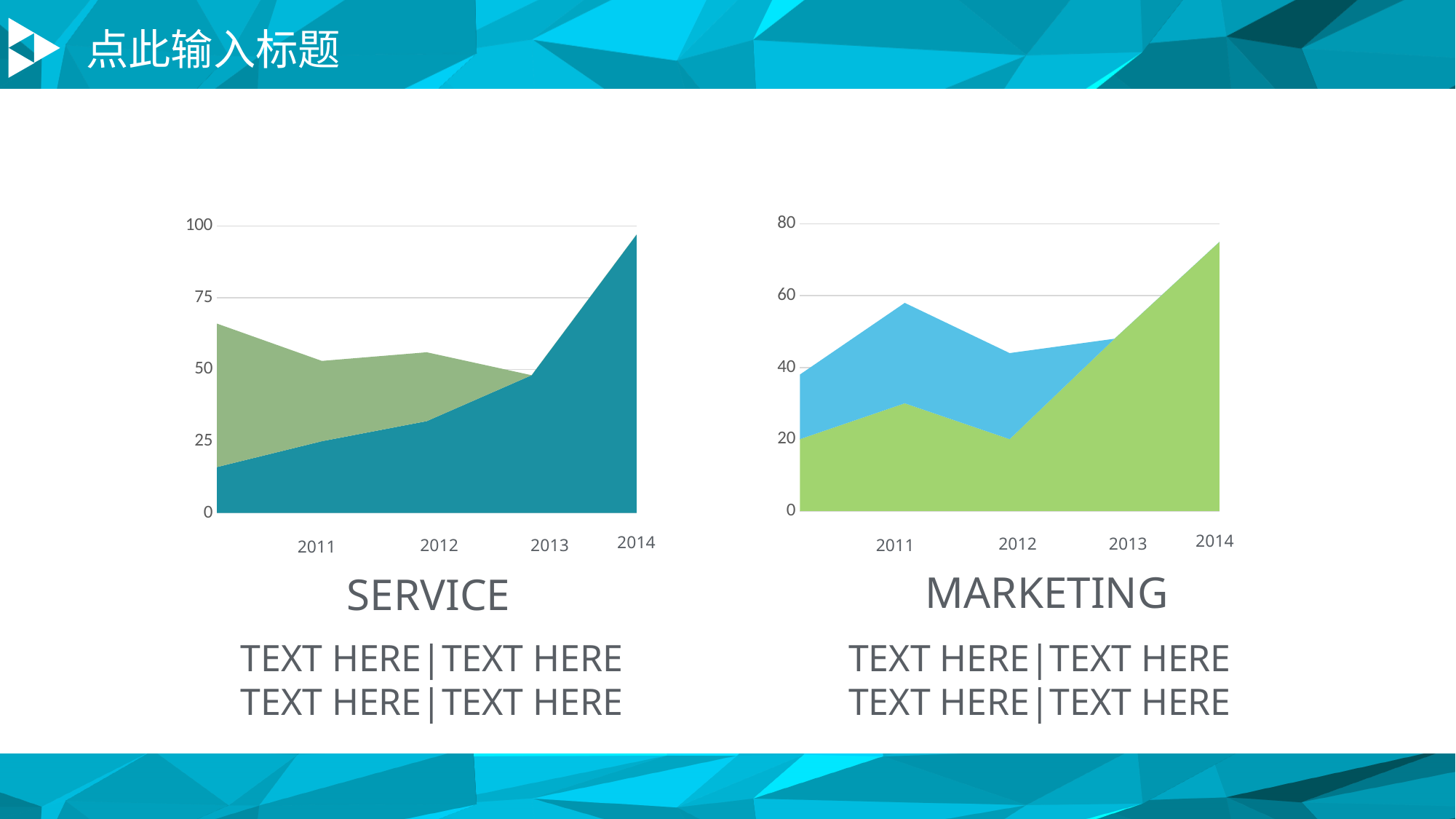
What kind of chart is the SERVICE chart? area chart What kind of chart is the MARKETING chart? area chart What is the highest value shown on the y axis of the MARKETING chart? 80 What is the title shown under the left chart? SERVICE In the SERVICE chart, in which year does the dark teal series reach its highest value? 2014 In the SERVICE chart, is the value of the dark teal series for 2014 greater or less than 75? greater In the SERVICE chart, does the dark teal series rise or fall from 2011 to 2014? rise In the MARKETING chart, is the value of the green series for 2014 greater or less than 60? greater In the MARKETING chart, in which year does the green series reach its highest value? 2014 In the SERVICE chart, is the value of the dark teal series for 2012 greater or less than 25? greater